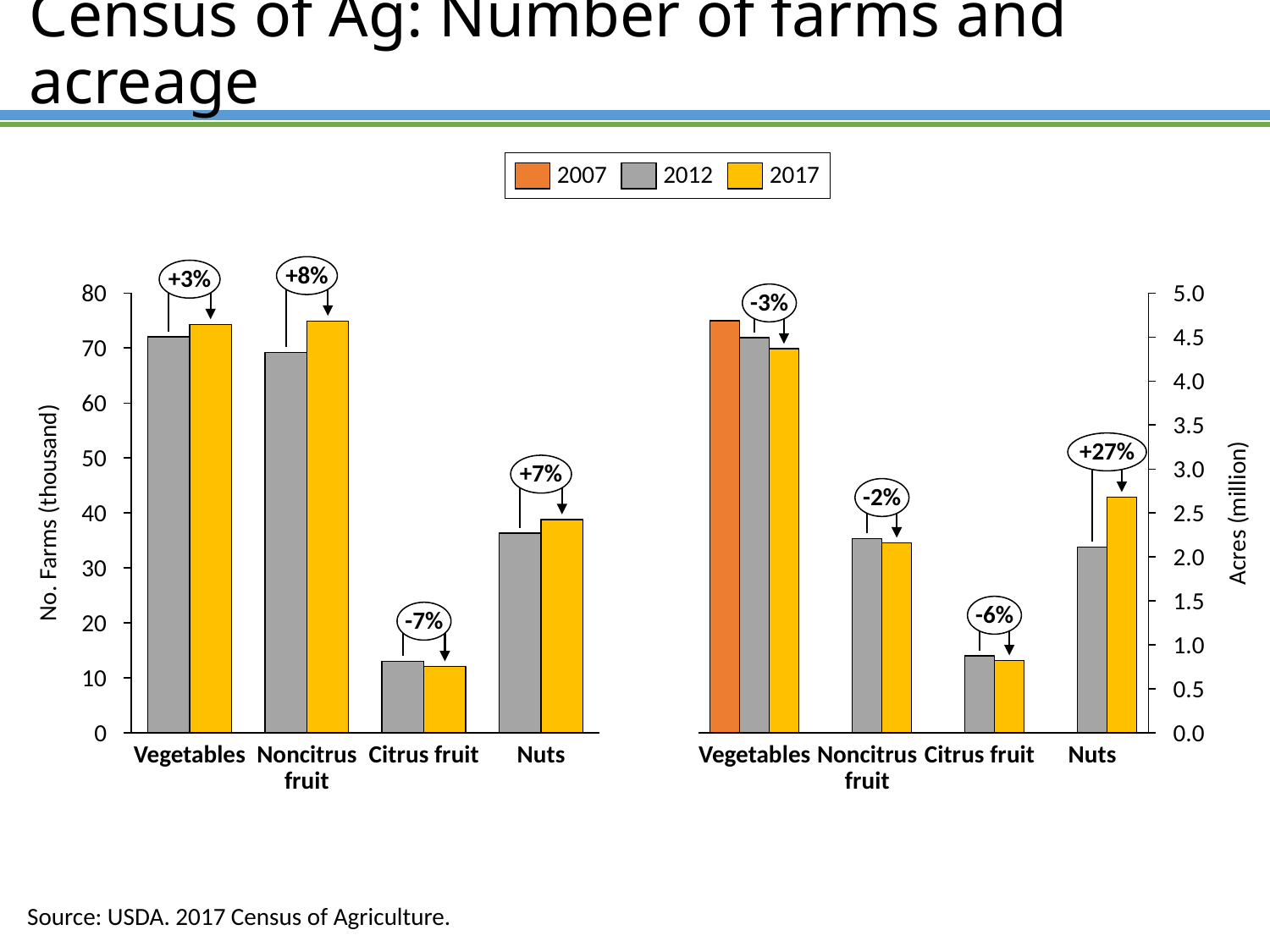
How many categories are shown on the left chart (No. Farms)? 4 On the left chart (No. Farms), what percent change is labelled for Citrus fruit? -7% On the right chart (Acres), which category has the highest acreage? Vegetables On the right chart (Acres), which is larger in 2017: Nuts or Noncitrus fruit? Nuts How many series does the legend list? 3 On the left chart (No. Farms), is the 2017 value for Nuts greater or less than 30? greater On the left chart (No. Farms), which category has the lowest number of farms? Citrus fruit What kind of chart is the right chart (Acres)? Bar chart On the left chart (No. Farms), what percent change is labelled for Noncitrus fruit? +8% On the right chart (Acres), what percent change is labelled for Nuts? +27% On the right chart (Acres), what percent change is labelled for Vegetables? -3% On the right chart (Acres), is the 2017 value for Citrus fruit greater or less than 1.0? less